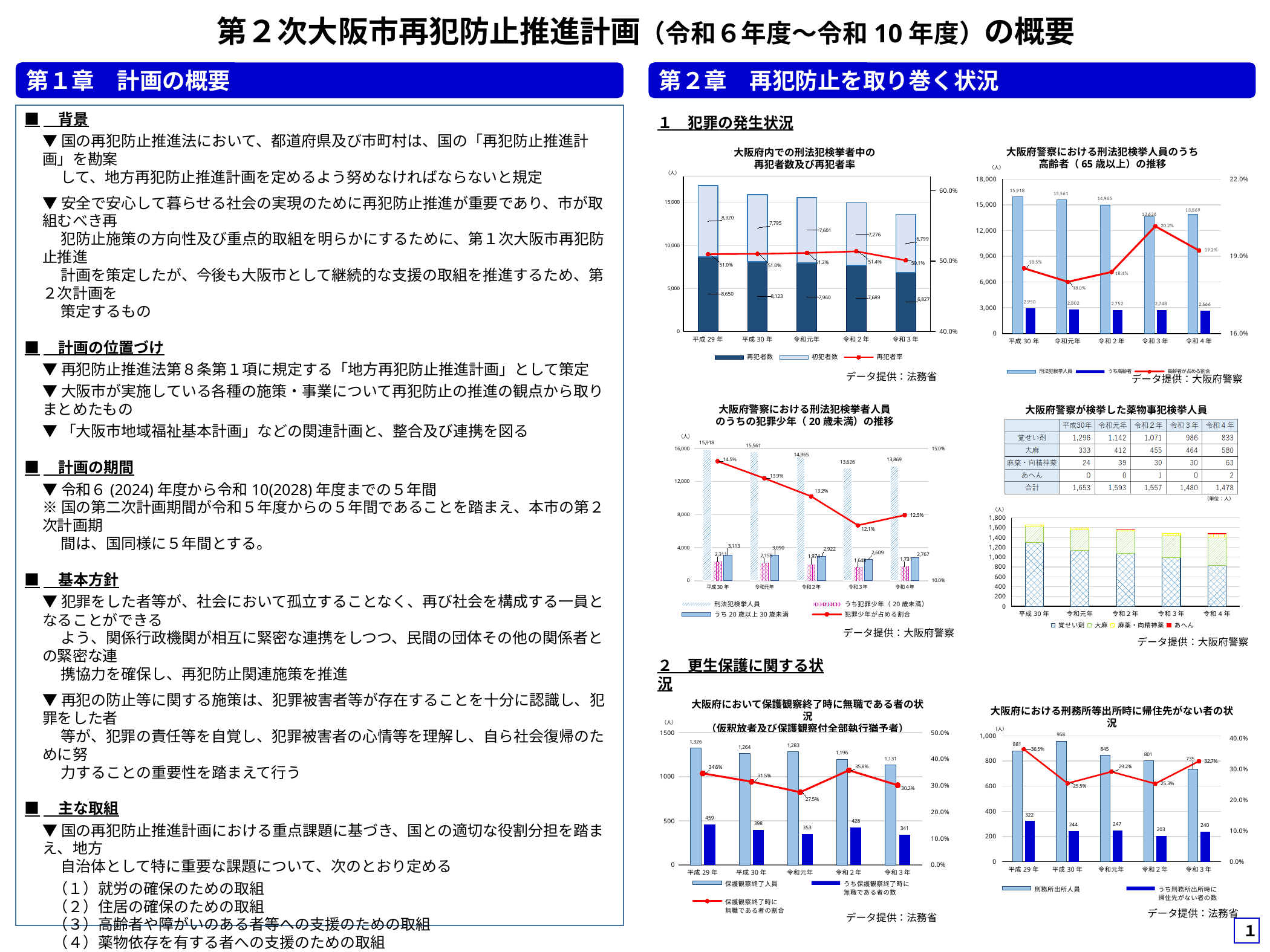
In the chart titled 大阪府において保護観察終了時に無職である者の状況, which year has the highest 保護観察終了時に無職である者の割合? 令和2年 In the chart titled 大阪府警察における刑法犯検挙人員のうち高齢者（65歳以上）の推移, what is the うち高齢者 value for 令和4年? 2,666 In the chart titled 大阪府内での刑法犯検挙者中の再犯者数及び再犯者率, what is the 再犯者率 for 令和2年? 51.4% In the chart titled 大阪府警察における刑法犯検挙人員のうち高齢者（65歳以上）の推移, which year has the highest 高齢者が占める割合? 令和3年 In the chart titled 大阪府における刑務所等出所時に帰住先がない者の状況, what is the 刑務所出所人員 value for 平成30年? 958 In the chart titled 大阪府における刑務所等出所時に帰住先がない者の状況, which is larger: the うち刑務所出所時に帰住先がない者の数 for 平成29年 or for 令和3年? 平成29年 In the table titled 大阪府警察が検挙した薬物事犯検挙人員, what is the 大麻 value for 令和4年? 580 In the chart titled 大阪府内での刑法犯検挙者中の再犯者数及び再犯者率, what is the 再犯者数 value for 令和3年? 6,827 In the chart titled 大阪府警察における刑法犯検挙者人員のうちの犯罪少年（20歳未満）の推移, what is the 犯罪少年が占める割合 for 平成30年? 14.5% In the chart titled 大阪府内での刑法犯検挙者中の再犯者数及び再犯者率, what is the total of the stacked bar for 平成29年? 16,970 In the chart titled 大阪府警察における刑法犯検挙者人員のうちの犯罪少年（20歳未満）の推移, what is the difference between the うち20歳以上30歳未満 values for 平成30年 and 令和4年? 346 In the table titled 大阪府警察が検挙した薬物事犯検挙人員, which year has the lowest 合計? 令和4年